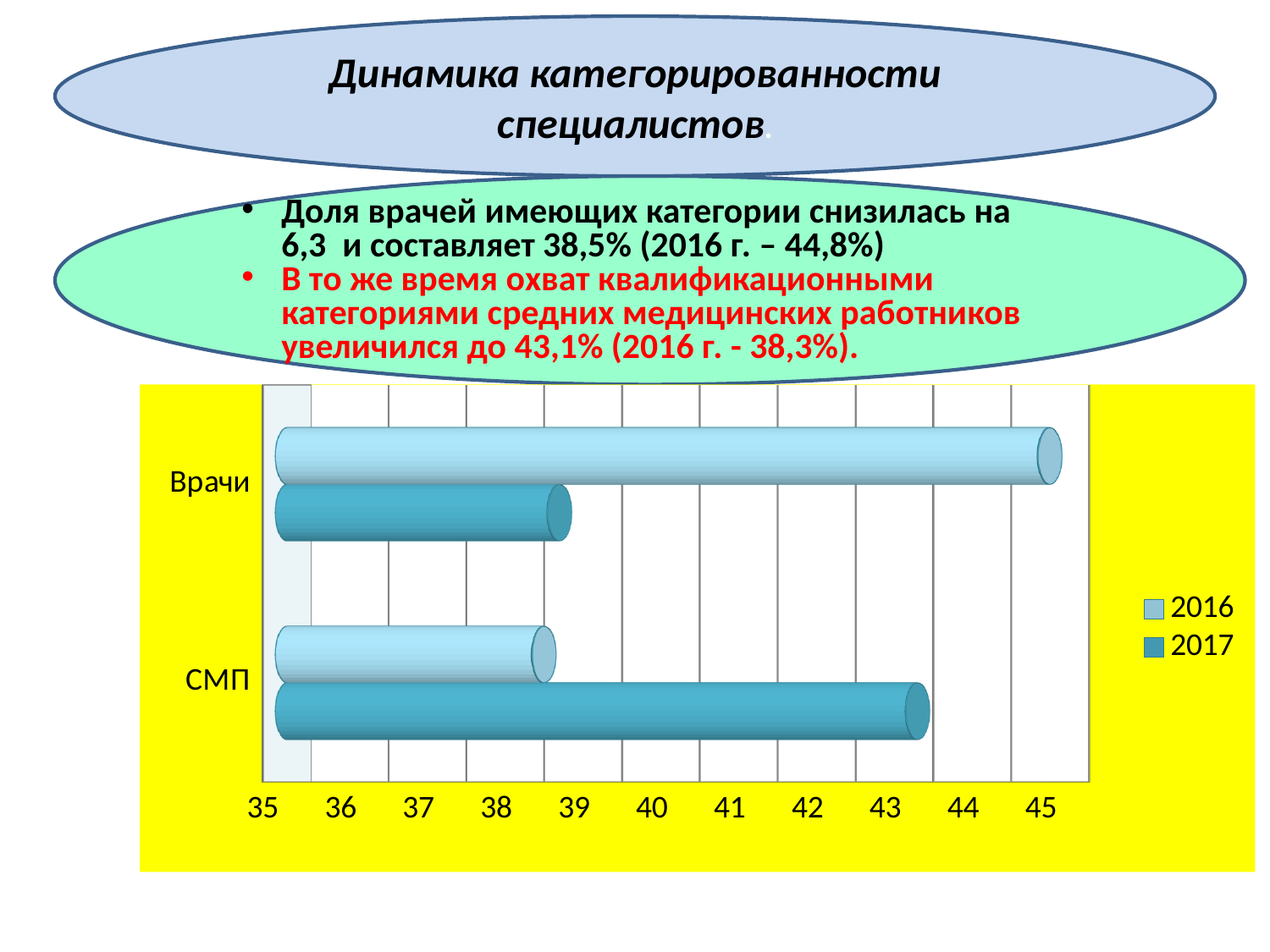
How many series does the chart legend list? 2 For Врачи, which series has the larger value, 2016 or 2017? 2016 Is the 2016 value for Врачи greater or less than 44? greater What are the two series listed in the chart legend? 2016 and 2017 What is the lowest value shown on the chart's horizontal axis? 35 For СМП, which series has the larger value, 2016 or 2017? 2017 What kind of chart is shown on the slide? bar chart Is the 2016 value for СМП greater or less than 39? less Is the 2017 value for Врачи greater or less than 40? less Which category has the longest bar on the chart? Врачи How many categories are shown on the chart's vertical axis? 2